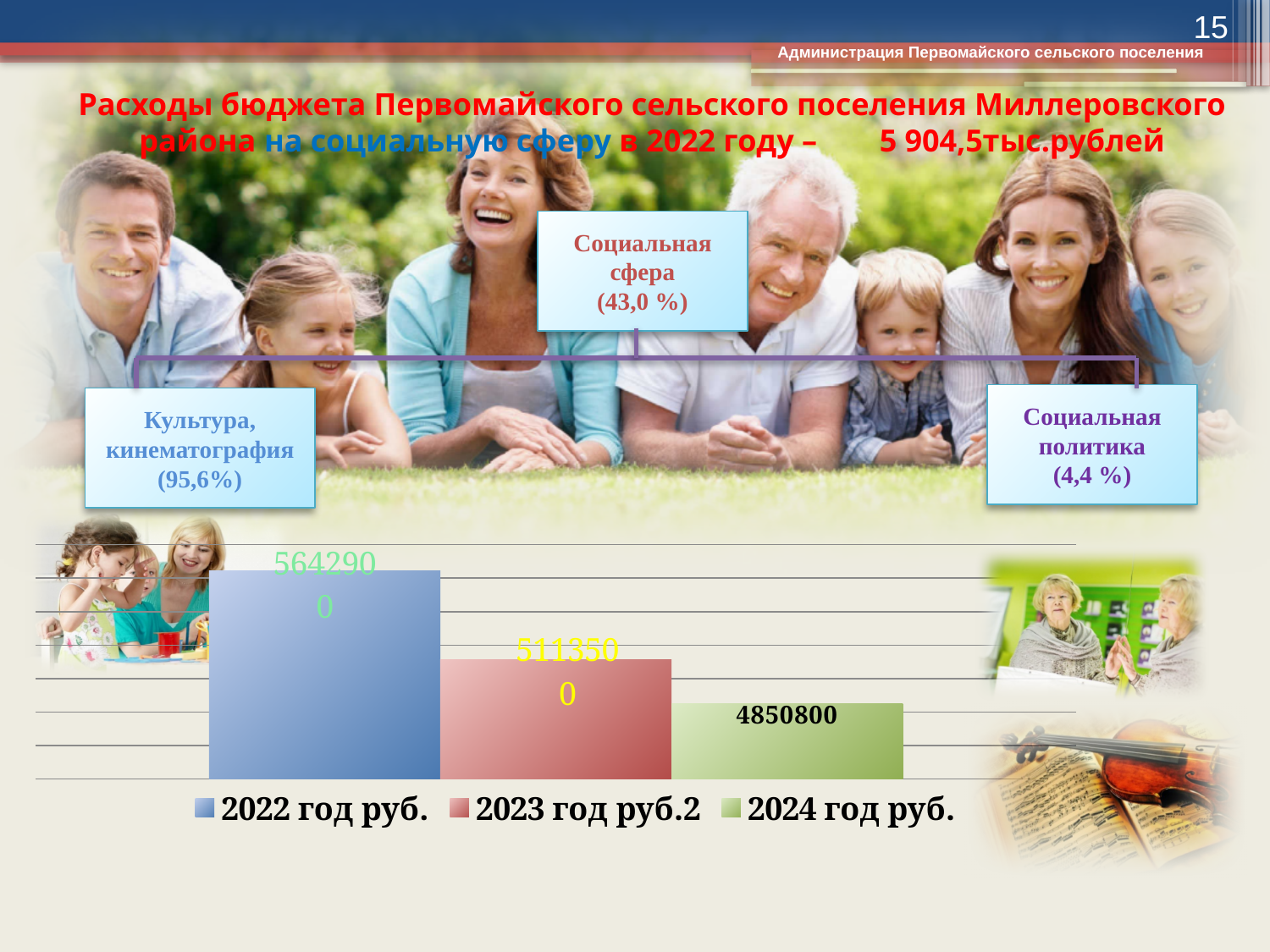
Which series has the highest value in the bar chart? 2022 год руб. What is the difference between the values for 2023 год руб.2 and 2024 год руб.? 262700 Do the values rise or fall from 2022 to 2024 in the chart? fall What is the value for 2024 год руб. in the bar chart? 4850800 What is the difference between the values for 2022 год руб. and 2023 год руб.2? 529400 Which series has the lowest value in the bar chart? 2024 год руб. How many series does the legend list? 3 What is the value for 2023 год руб.2 in the bar chart? 5113500 What is the value for 2022 год руб. in the bar chart? 5642900 Which is larger, the value for 2022 год руб. or the value for 2024 год руб.? 2022 год руб. How many bars are plotted in the chart? 3 What kind of chart is shown on the slide? bar chart